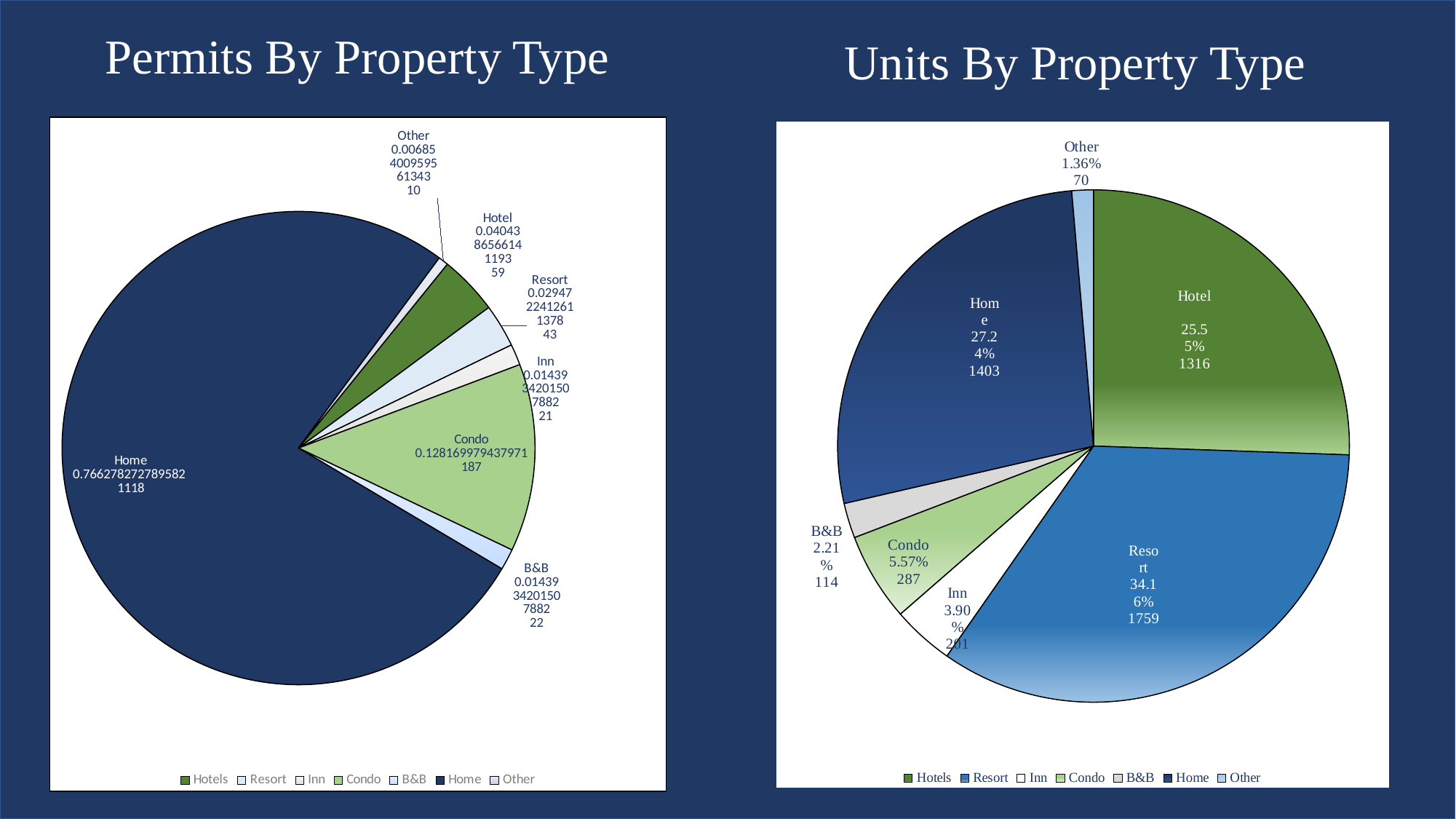
In the Permits By Property Type chart, what is the difference between the Hotel count and the Resort count? 16 In the Units By Property Type chart, how many units are shown for Resort? 1759 In the Permits By Property Type chart, which property type has the smallest slice? Other In the Units By Property Type chart, which has more units, Home or Hotel? Home In the Permits By Property Type chart, how many permits are shown for Home? 1118 In the Units By Property Type chart, what share of the pie does Hotel represent? 25.55% In the Permits By Property Type chart, which property type has the largest slice? Home In the Units By Property Type chart, which property type has the largest slice? Resort How many slices does the Units By Property Type pie chart have? 7 What type of chart is used for Permits By Property Type? Pie chart In the Units By Property Type chart, which property type has the smallest slice? Other In the Permits By Property Type chart, how many permits are shown for Condo? 187